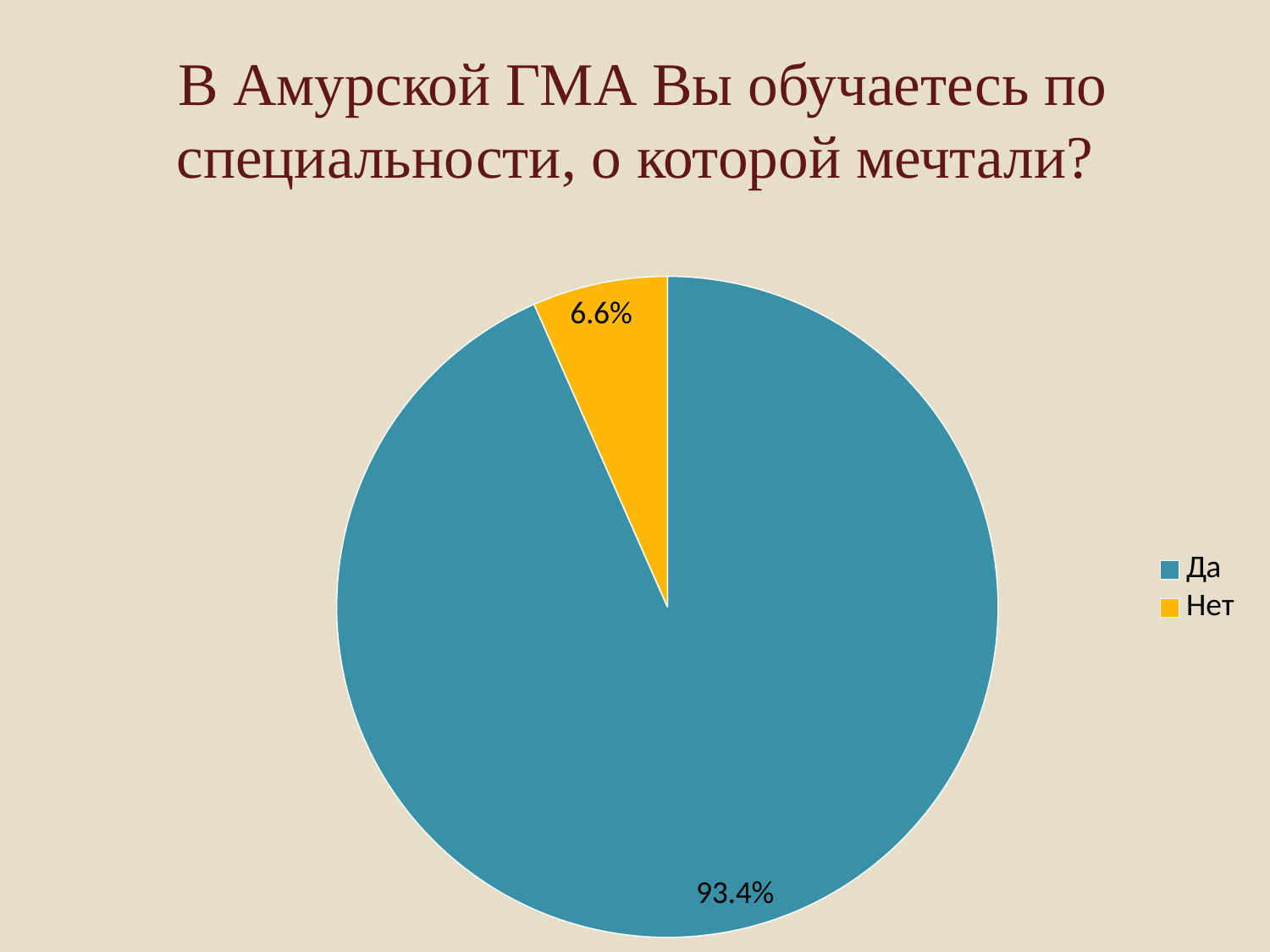
What is the difference between the shares for "Да" and "Нет"? 86.8% What colour is the slice for "Нет"? yellow What percentage of the pie is labelled "Нет"? 6.6% How many slices does the pie chart have? 2 Which is larger, the share for "Да" or the share for "Нет"? Да What colour is the slice for "Да"? blue What percentage of the pie is labelled "Да"? 93.4% How many entries does the legend list? 2 What kind of chart is shown on the slide? pie chart Which category has the smallest share of the pie? Нет Which category has the largest share of the pie? Да